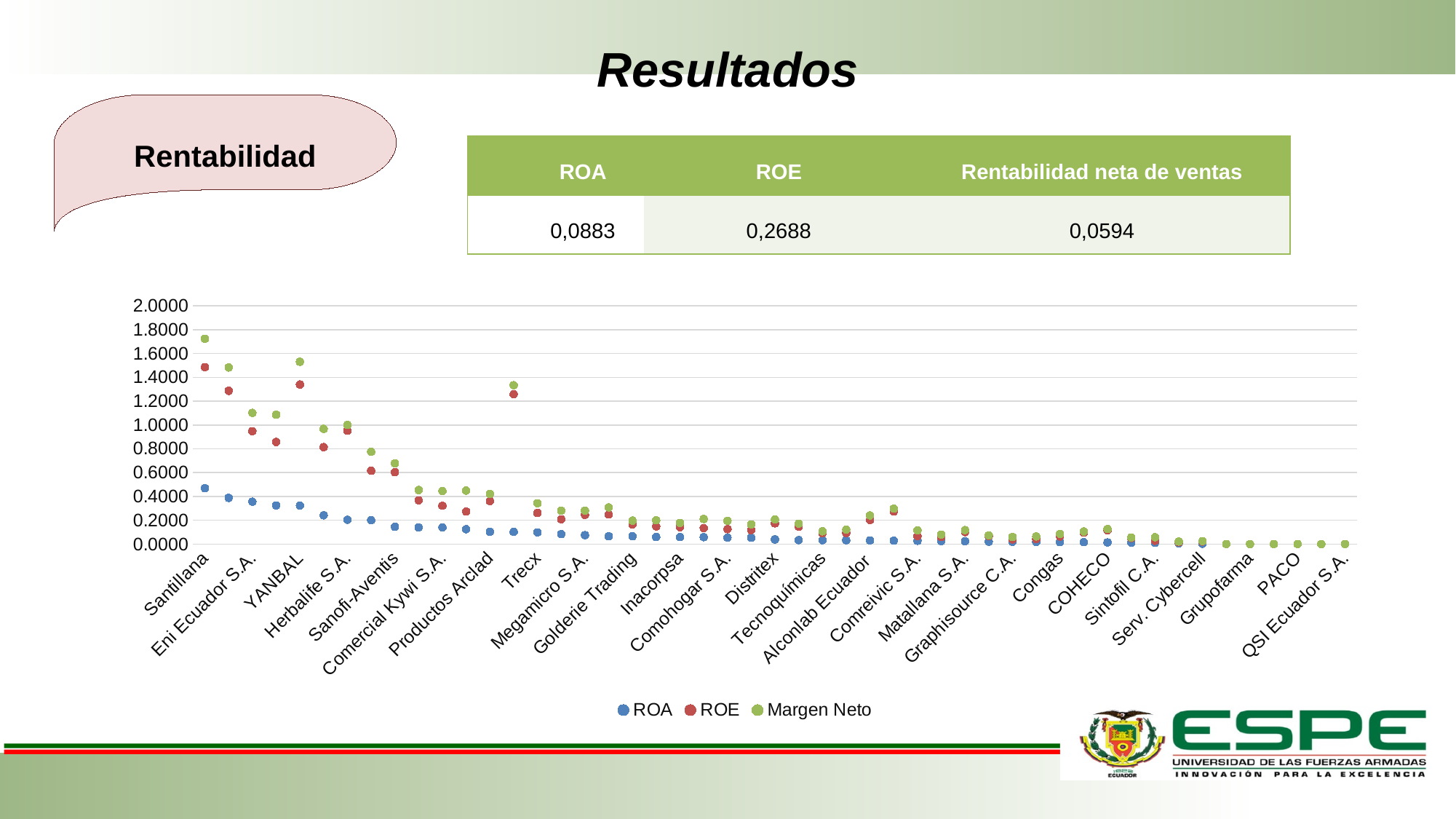
What kind of chart is shown on the slide? scatter chart How many series does the chart legend list? 3 What are the three series listed in the chart legend? ROA, ROE, Margen Neto Is the ROE value for Herbalife S.A. greater or less than 1.0? less Which company has the highest Margen Neto value in the chart? Santillana Do the values generally rise or fall moving from left to right along the x axis? fall Is the ROA value for Santillana greater or less than 0.4? greater